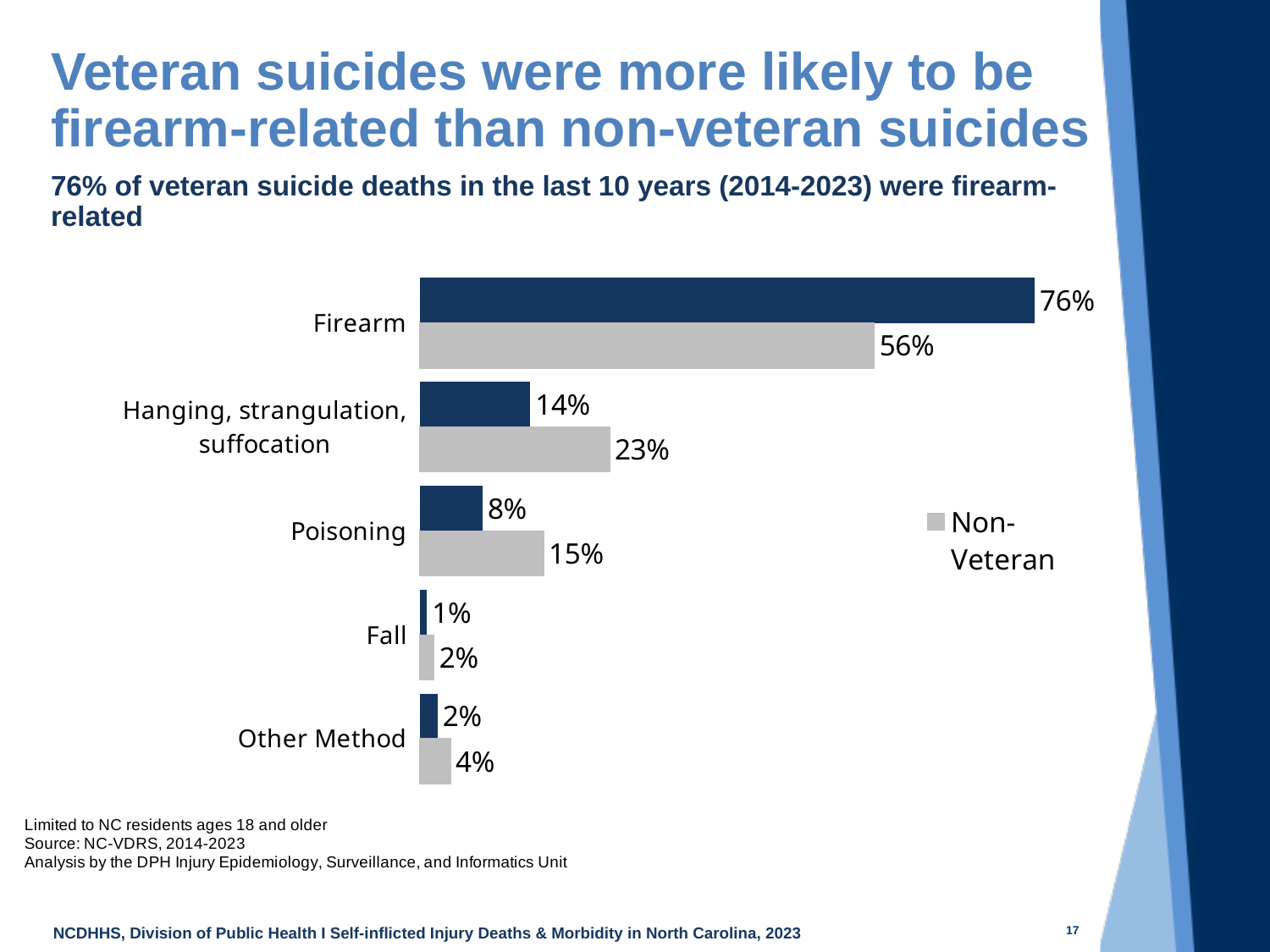
What colour are the Non-Veteran bars? Grey What is the veteran (dark blue) value for Poisoning? 8% What kind of chart is shown on the slide? Bar chart What is the Non-Veteran value for Hanging, strangulation, suffocation? 23% Which category has the highest Non-Veteran value? Firearm What is the difference between the veteran (dark blue) and Non-Veteran values for Firearm? 20 percentage points How many categories are shown on the chart? 5 What is the Non-Veteran value for Firearm? 56% Which category has the lowest Non-Veteran value? Fall What is the difference between the Non-Veteran and veteran (dark blue) values for Poisoning? 7 percentage points For Hanging, strangulation, suffocation, which is larger: the veteran (dark blue) value or the Non-Veteran value? Non-Veteran What is the Non-Veteran value for Other Method? 4%